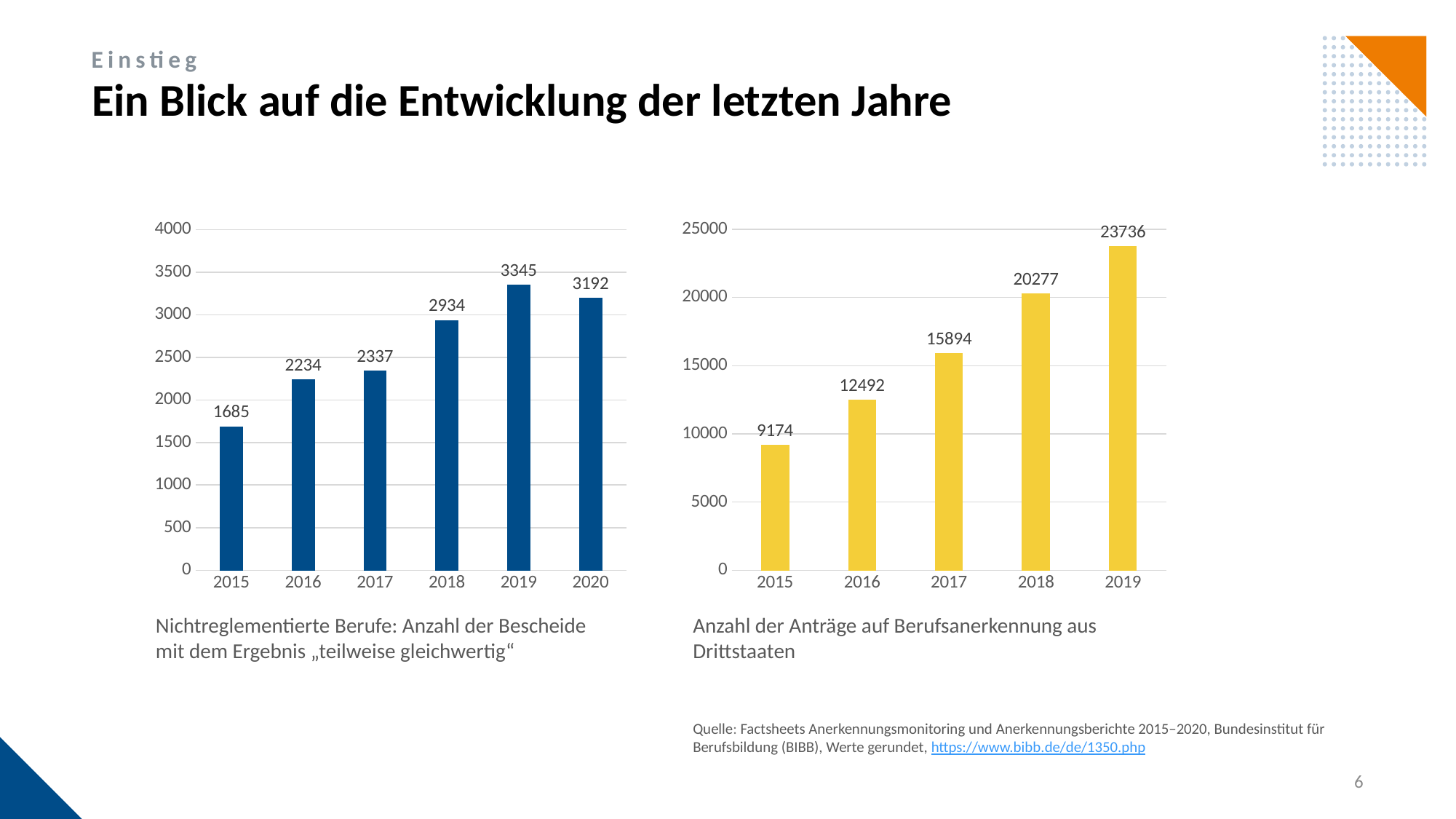
In the left chart (Nichtreglementierte Berufe), which is larger, the value for 2016 or the value for 2017? 2017 How many years are shown in the right chart (Anzahl der Anträge aus Drittstaaten)? 5 How many years are shown in the left chart (Nichtreglementierte Berufe)? 6 What kind of chart is the right chart (Anzahl der Anträge aus Drittstaaten)? Bar chart In the left chart (Nichtreglementierte Berufe), what is the value for 2018? 2934 In the right chart (Anzahl der Anträge aus Drittstaaten), what is the difference between the values for 2019 and 2018? 3459 In the right chart (Anzahl der Anträge aus Drittstaaten), do the values rise or fall from 2015 to 2019? Rise In the right chart (Anzahl der Anträge aus Drittstaaten), which year has the lowest value? 2015 In the left chart (Nichtreglementierte Berufe), which year has the highest value? 2019 In the right chart (Anzahl der Anträge aus Drittstaaten), is the value for 2016 greater or less than 10000? greater In the right chart (Anzahl der Anträge auf Berufsanerkennung aus Drittstaaten), what is the value for 2017? 15894 In the left chart (Nichtreglementierte Berufe), what is the difference between the values for 2019 and 2020? 153